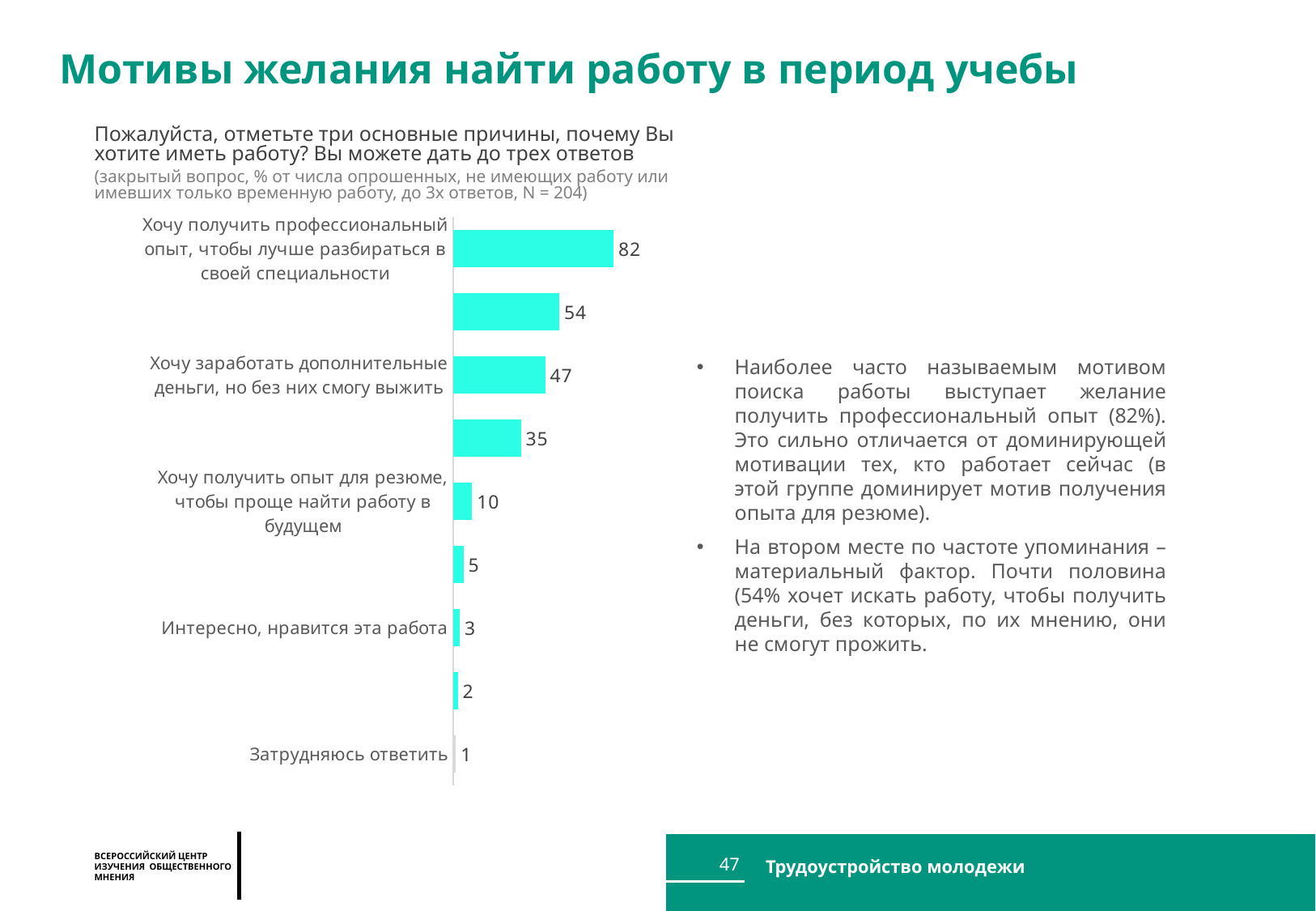
What is the sample size (N) stated in the chart subtitle? N = 204 What is the value for "Хочу получить опыт для резюме, чтобы проще найти работу в будущем"? 10 What is the value for "Затрудняюсь ответить"? 1 Which category has the highest value? Хочу получить профессиональный опыт, чтобы лучше разбираться в своей специальности What is the value for "Хочу заработать дополнительные деньги, но без них смогу выжить"? 47 What is the difference between the values for "Хочу получить профессиональный опыт, чтобы лучше разбираться в своей специальности" and "Хочу заработать дополнительные деньги, но без них смогу выжить"? 35 Which category has the lowest value? Затрудняюсь ответить Which is larger: the value for "Хочу получить опыт для резюме, чтобы проще найти работу в будущем" or for "Интересно, нравится эта работа"? Хочу получить опыт для резюме, чтобы проще найти работу в будущем How many bars are plotted in the chart? 9 What is the value for "Интересно, нравится эта работа"? 3 What is the value for "Хочу получить профессиональный опыт, чтобы лучше разбираться в своей специальности"? 82 What type of chart is shown on the slide? Bar chart